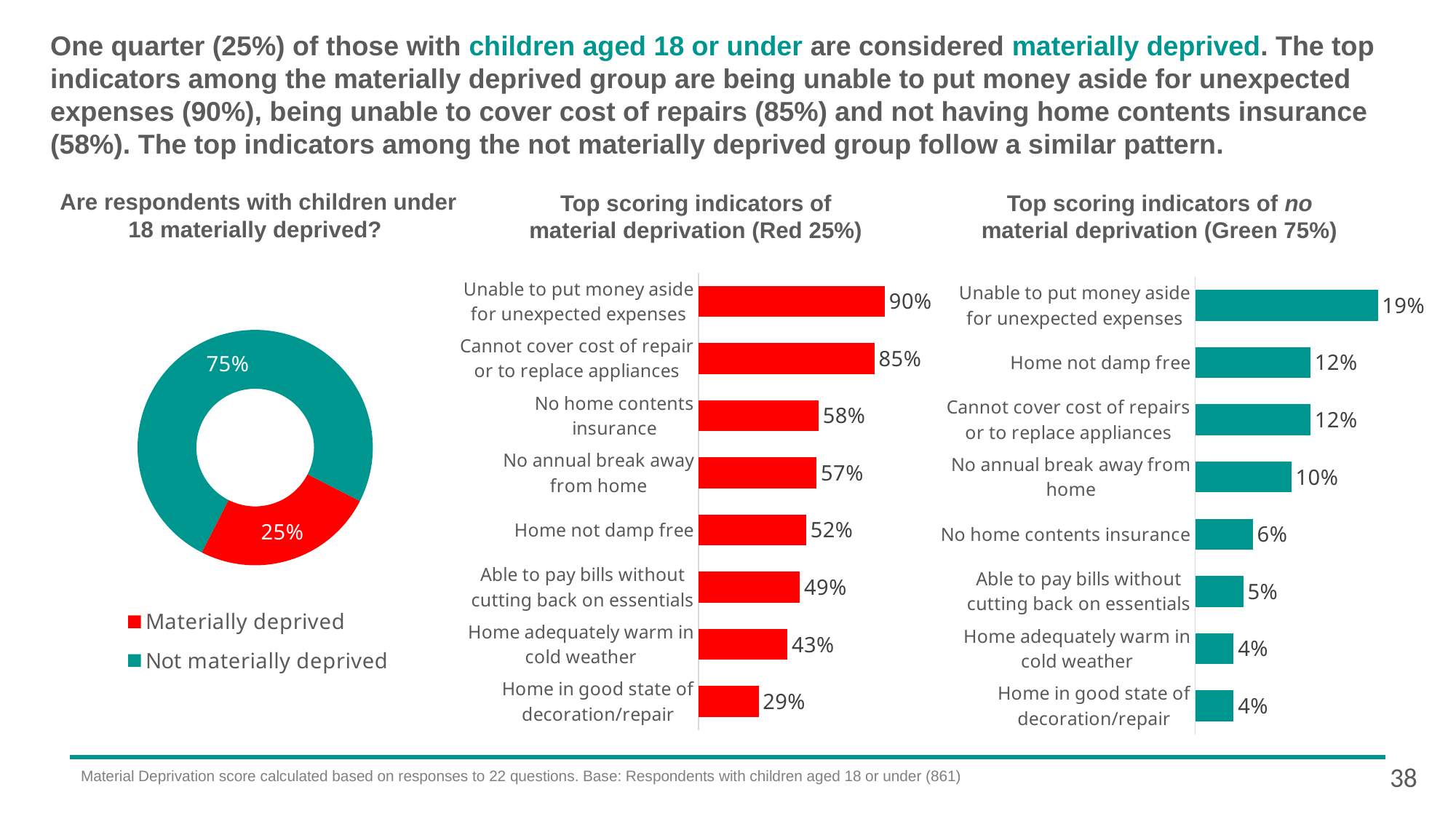
In the donut chart 'Are respondents with children under 18 materially deprived?', what share is materially deprived? 25% In the chart 'Top scoring indicators of no material deprivation (Green 75%)', what is the value for 'No home contents insurance'? 6% What kind of chart is 'Top scoring indicators of no material deprivation (Green 75%)'? Bar chart In the chart 'Top scoring indicators of no material deprivation (Green 75%)', which is larger: 'Home not damp free' or 'No annual break away from home'? Home not damp free In the donut chart on the left, what share is not materially deprived? 75% In the chart 'Top scoring indicators of no material deprivation (Green 75%)', what is the value for 'Unable to put money aside for unexpected expenses'? 19% In the chart 'Top scoring indicators of material deprivation (Red 25%)', which indicator has the highest value? Unable to put money aside for unexpected expenses What kind of chart is the left-hand chart 'Are respondents with children under 18 materially deprived?' Donut (pie) chart In the chart 'Top scoring indicators of material deprivation (Red 25%)', what is the value for 'No home contents insurance'? 58% In the chart 'Top scoring indicators of material deprivation (Red 25%)', which indicator has the lowest value? Home in good state of decoration/repair In the chart 'Top scoring indicators of material deprivation (Red 25%)', what is the difference between 'Unable to put money aside for unexpected expenses' and 'Cannot cover cost of repair or to replace appliances'? 5 percentage points How many indicators are shown in the chart 'Top scoring indicators of material deprivation (Red 25%)'? 8